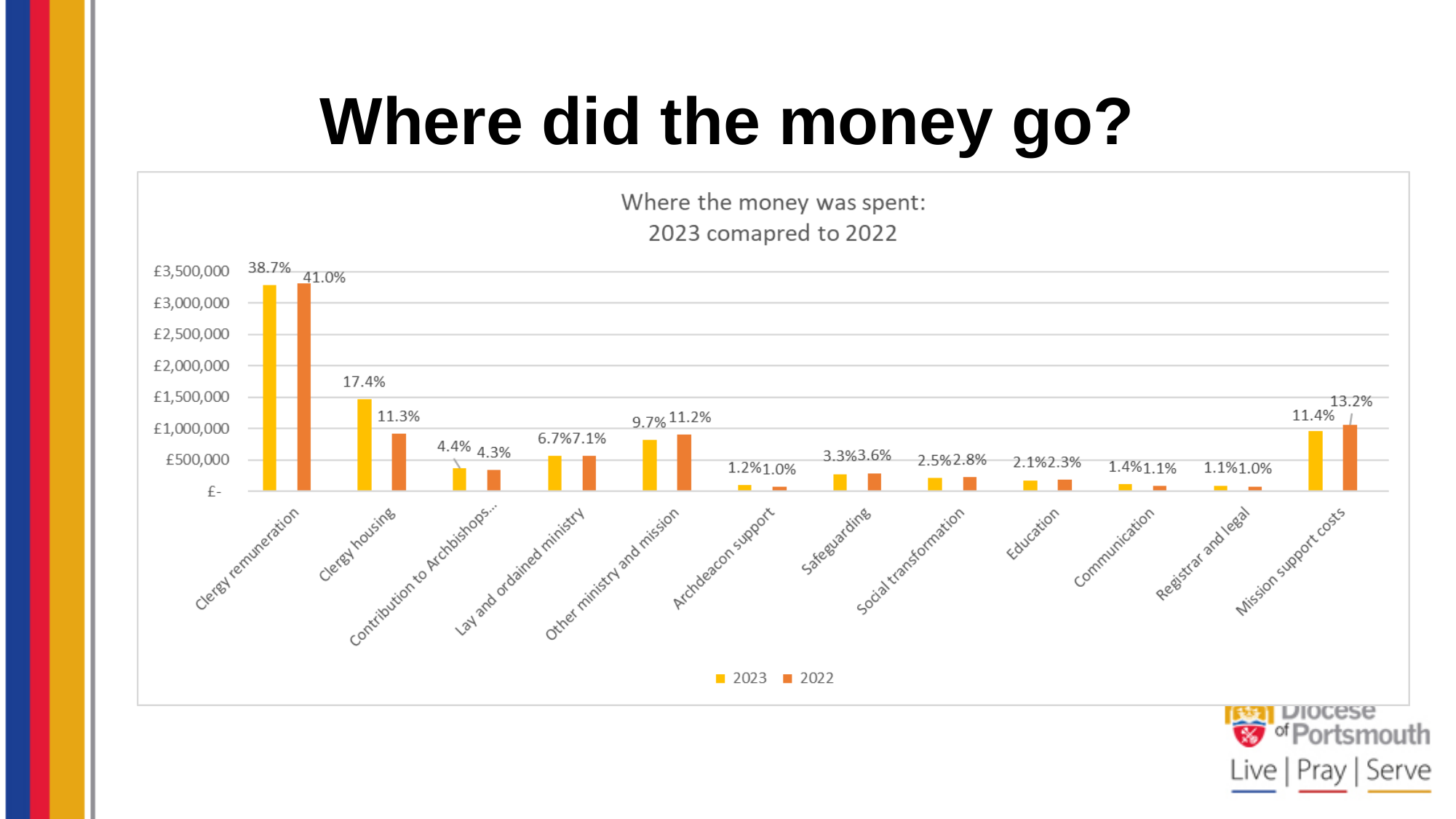
What percentage label is shown for the 2022 bar for Mission support costs? 13.2% How many series does the legend list? 2 What kind of chart is shown on the slide? Bar chart What percentage label is shown for the 2023 bar for Clergy remuneration? 38.7% Is the 2023 value for Clergy remuneration greater or less than £3,000,000? greater How many spending categories are shown on the x axis? 12 Is the 2022 value for Clergy housing greater or less than £1,000,000? less What percentage label is shown for the 2023 bar for Clergy housing? 17.4% For Other ministry and mission, which year has the larger bar, 2023 or 2022? 2022 What is the difference in percentage points between the 2023 labels for Clergy remuneration (38.7%) and Clergy housing (17.4%)? 21.3 percentage points Which category has the highest spending in 2023? Clergy remuneration